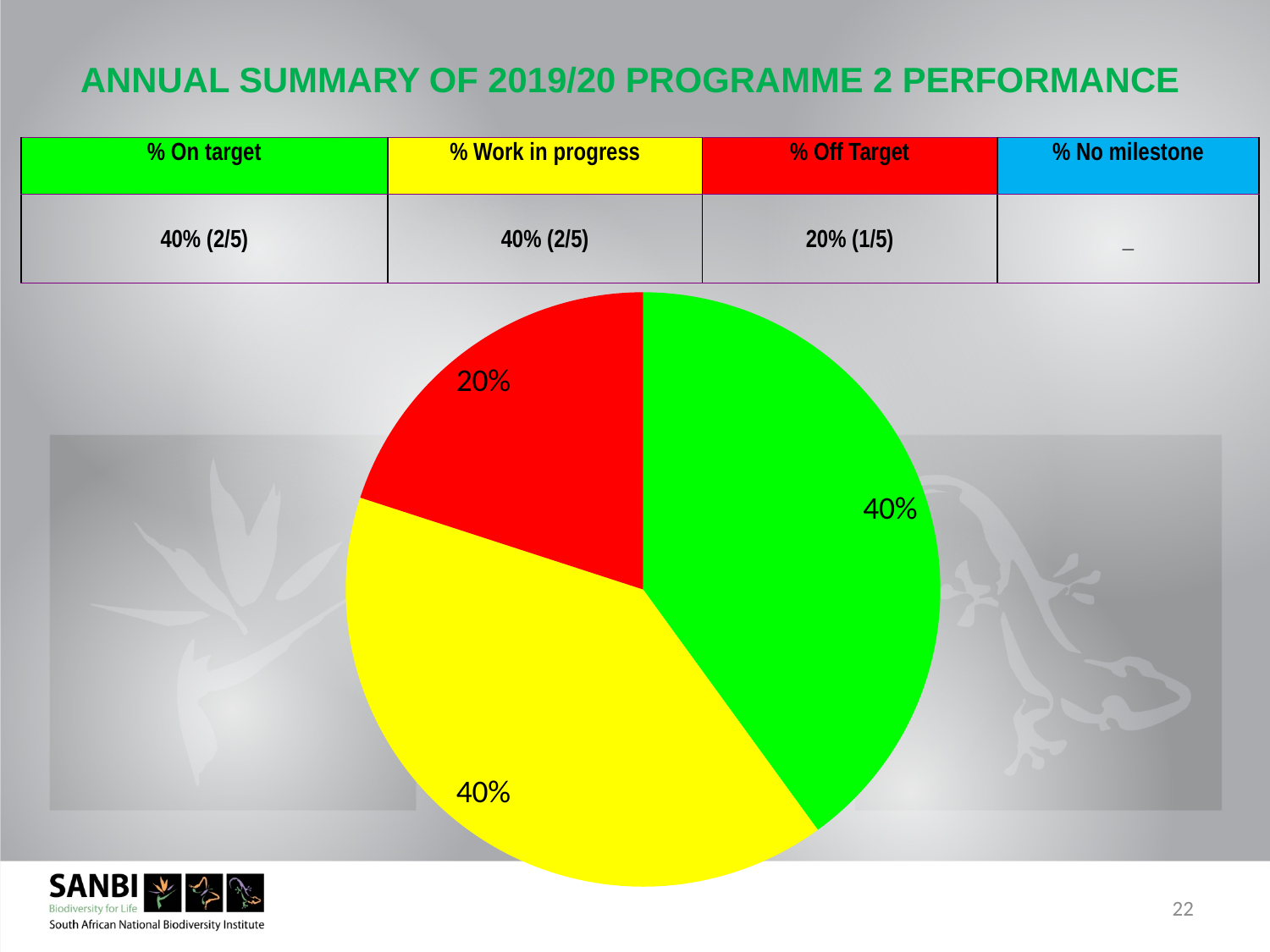
Is the value for the red slice of the pie chart greater or less than 25%? less Which slice of the pie chart is the smallest? the red slice (20%) Using the colour key in the table, which category does the yellow slice of the pie chart represent? % Work in progress How many slices does the pie chart have? 3 What is the difference between the green slice and the red slice of the pie chart? 20% What percentage is shown on the yellow slice of the pie chart? 40% Is the red slice of the pie chart larger or smaller than the green slice? smaller What percentage is shown on the red slice of the pie chart? 20% Using the colour key in the table, which category does the red slice of the pie chart represent? % Off Target What percentage is shown on the green slice of the pie chart? 40% What share of the pie chart do the green and yellow slices make up together? 80% What kind of chart is shown on the slide? pie chart